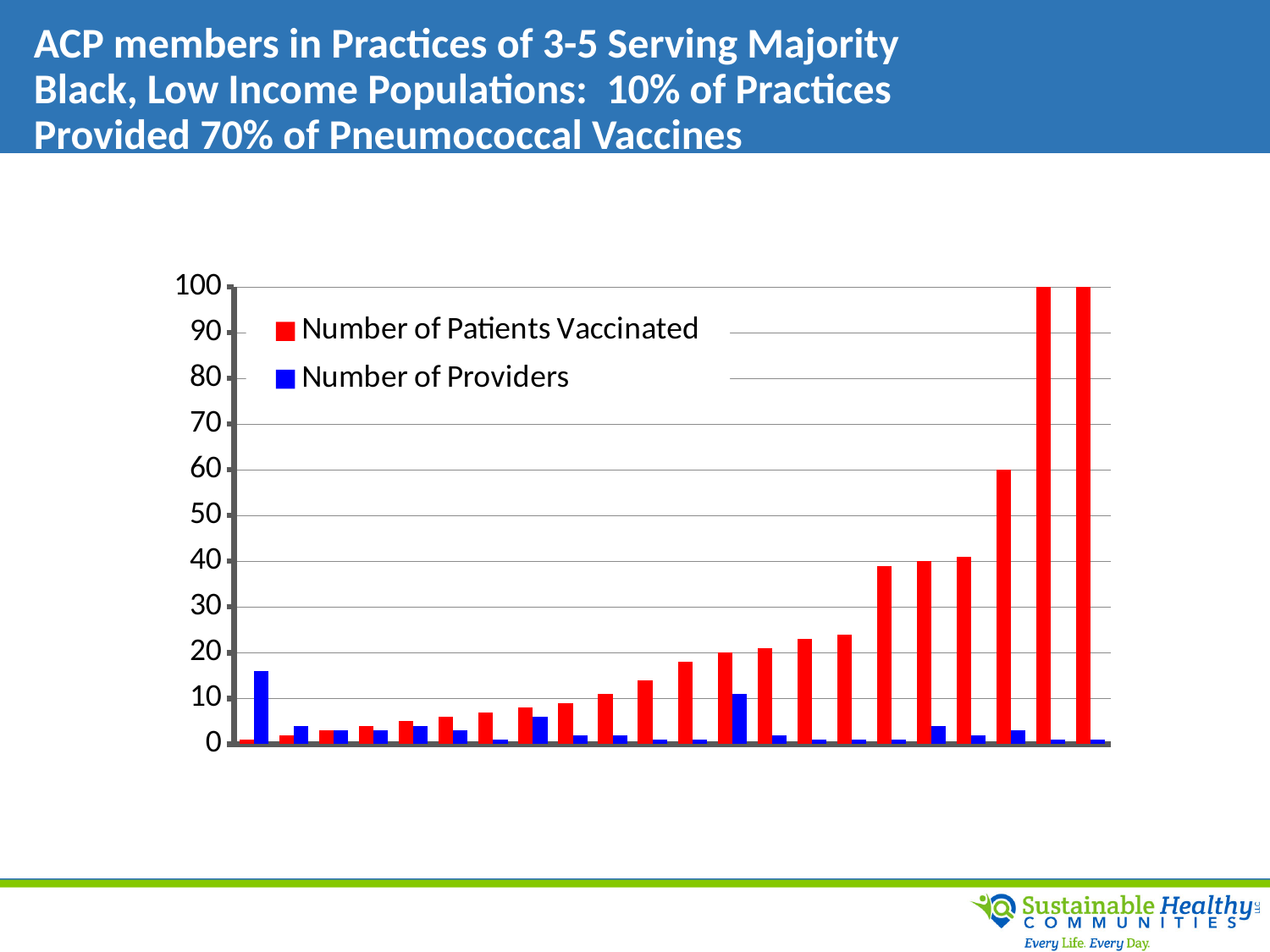
Is the tallest Number of Providers bar greater or less than 20? less How many Number of Patients Vaccinated bars reach the top of the axis at 100? 2 Is the leftmost Number of Patients Vaccinated bar greater or less than 10? less How many practices (pairs of bars) are plotted along the x axis? 22 How many series does the legend list? 2 Is the tallest Number of Providers bar greater or less than 10? greater What are the two series named in the legend? Number of Patients Vaccinated; Number of Providers Do the Number of Patients Vaccinated bars generally rise or fall from left to right? rise What kind of chart is shown on the slide? bar chart Which series has the tallest bar in the chart? Number of Patients Vaccinated Which colour represents Number of Providers in the chart? blue For the rightmost practice, which series has the larger value? Number of Patients Vaccinated